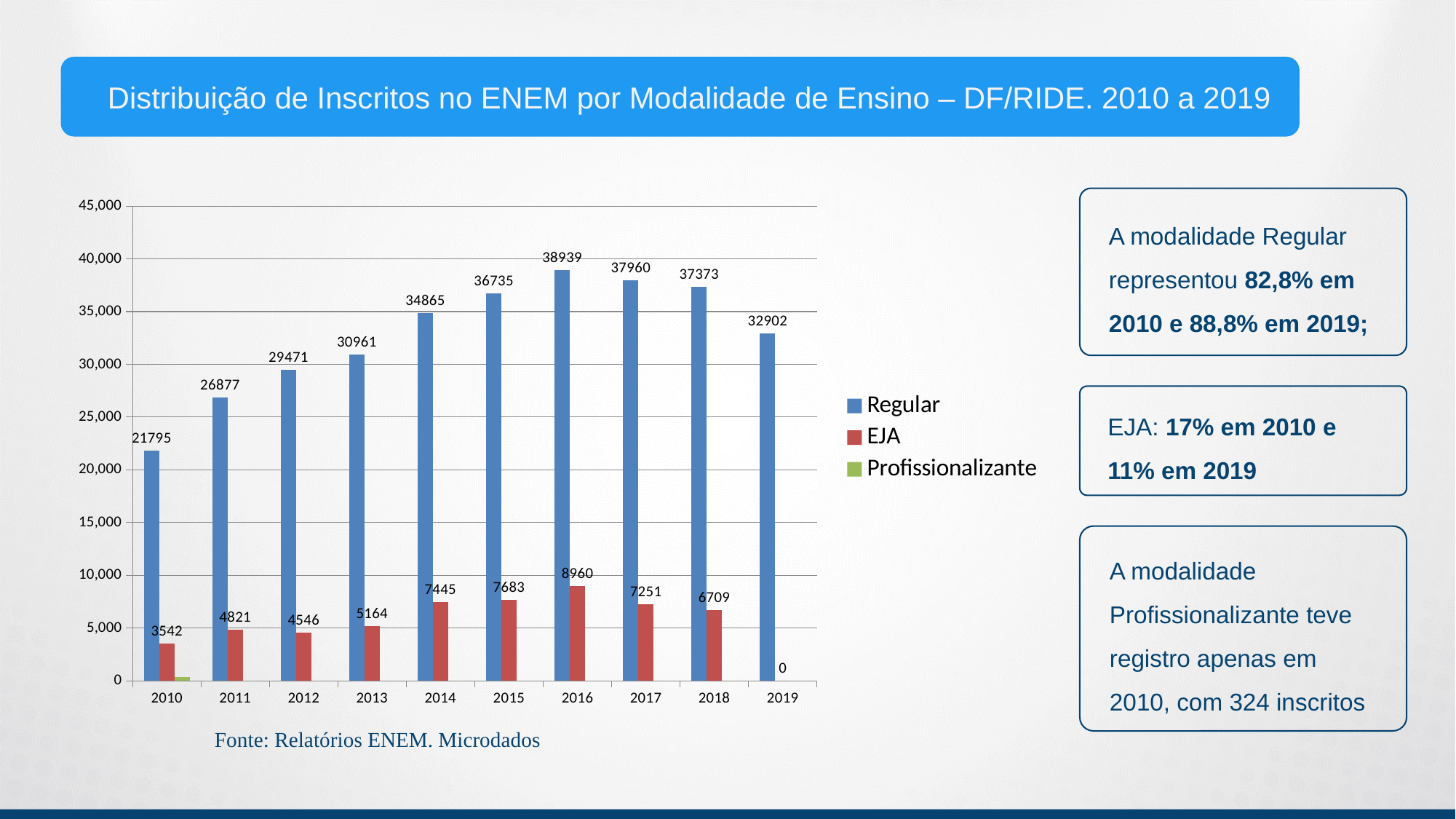
What is the difference between the Regular values in 2017 and 2018? 587 In which year is the Regular series lowest? 2010 Is the Regular value for 2012 greater or less than 30,000? less What type of chart is shown on the slide? bar chart What is the value for EJA in 2013? 5164 How many years are shown on the x axis? 10 How many series does the legend list? 3 What is the value for Regular in 2019? 32902 Which is larger, the EJA value in 2014 or in 2015? 2015 What is the value for Regular in 2016? 38939 In which year is the Regular series highest? 2016 Which series is shown in green in the legend? Profissionalizante